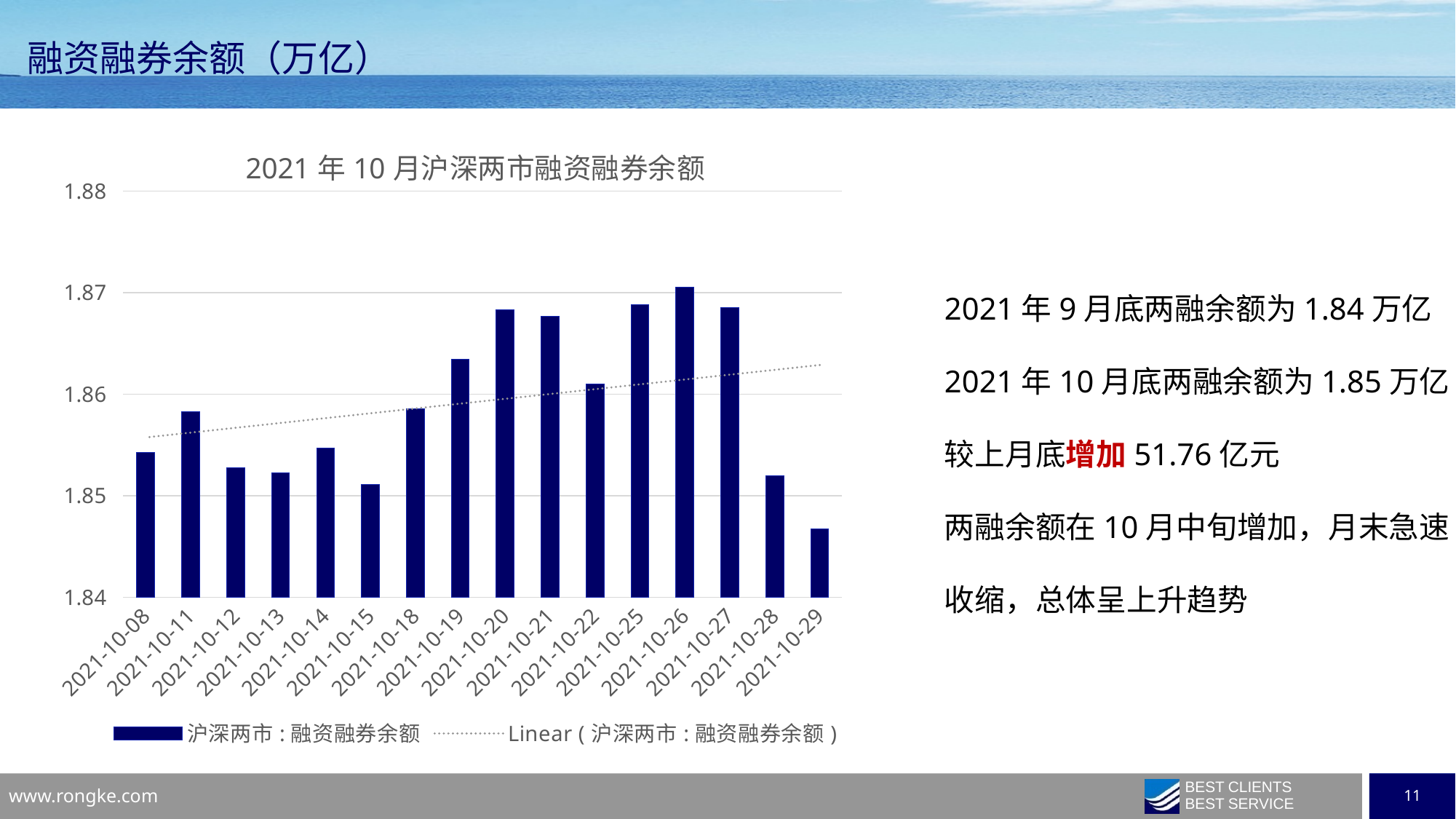
Which is larger, the value for 2021-10-11 or the value for 2021-10-12? 2021-10-11 How many entries does the chart legend list? 2 Does the dotted linear trendline rise or fall from left to right? rise Is the value for 2021-10-08 greater or less than 1.85? greater Which date has the highest 融资融券余额 in the chart? 2021-10-26 Which date has the lowest 融资融券余额 in the chart? 2021-10-29 How many dates (bars) are plotted in the chart? 16 Which is larger, the value for 2021-10-26 or the value for 2021-10-28? 2021-10-26 What is the title of the chart? 2021年10月沪深两市融资融券余额 Is the value for 2021-10-20 greater or less than 1.86? greater Is the value for 2021-10-29 greater or less than 1.85? less What kind of chart is shown on the slide? Bar chart